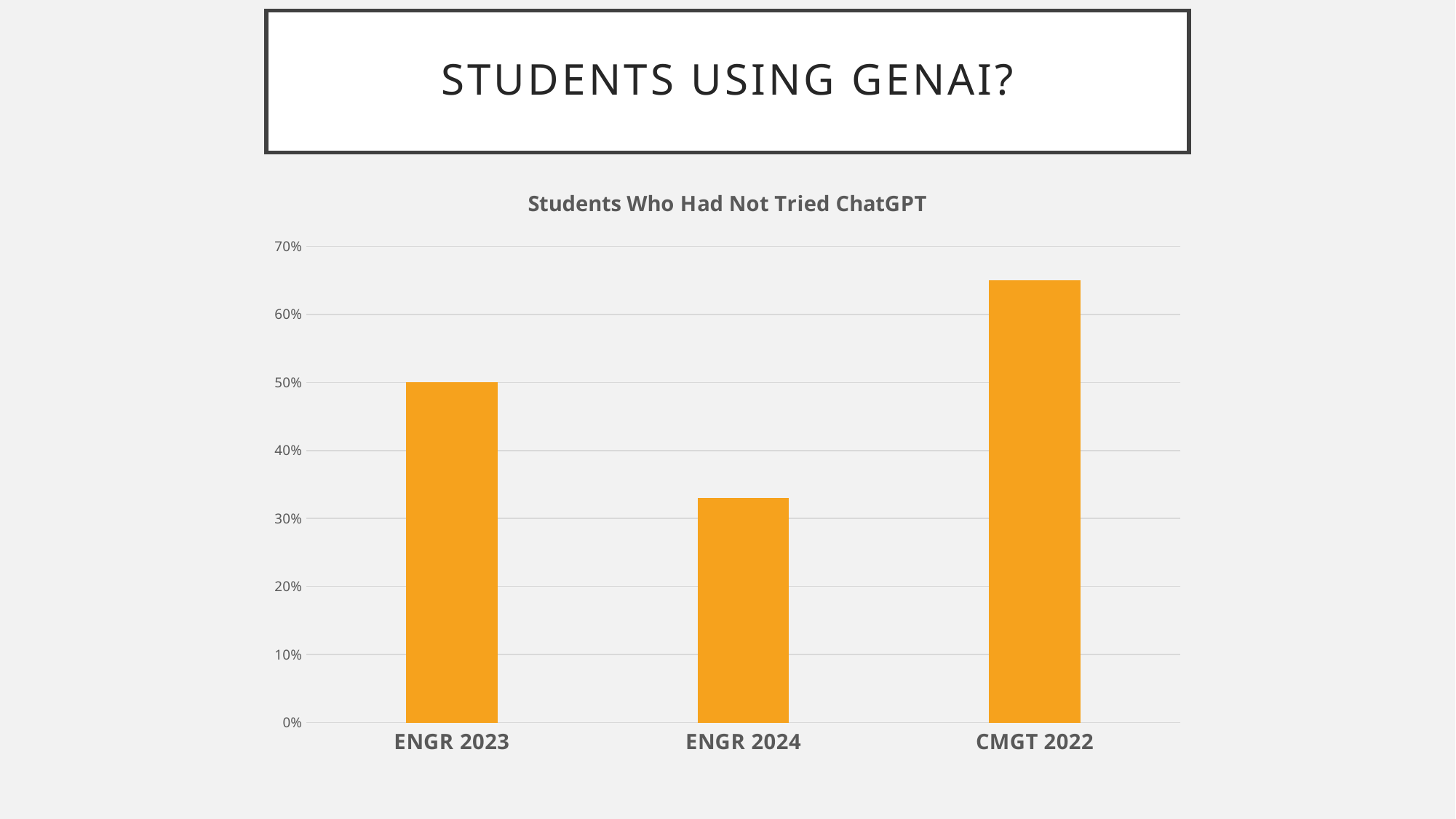
Which is larger, the value for CMGT 2022 or the value for ENGR 2023? CMGT 2022 What kind of chart is shown on the slide? bar chart Which category has the lowest value? ENGR 2024 Is the value for ENGR 2024 greater or less than 40%? less How many categories are shown in the chart? 3 What is the title of the chart? Students Who Had Not Tried ChatGPT Is the value for CMGT 2022 greater or less than 60%? greater What is the value for ENGR 2023? 50% Is the value for ENGR 2024 greater or less than 30%? greater Which is larger, the value for ENGR 2023 or the value for ENGR 2024? ENGR 2023 Which category has the highest value? CMGT 2022 What colour are the bars in the chart? orange